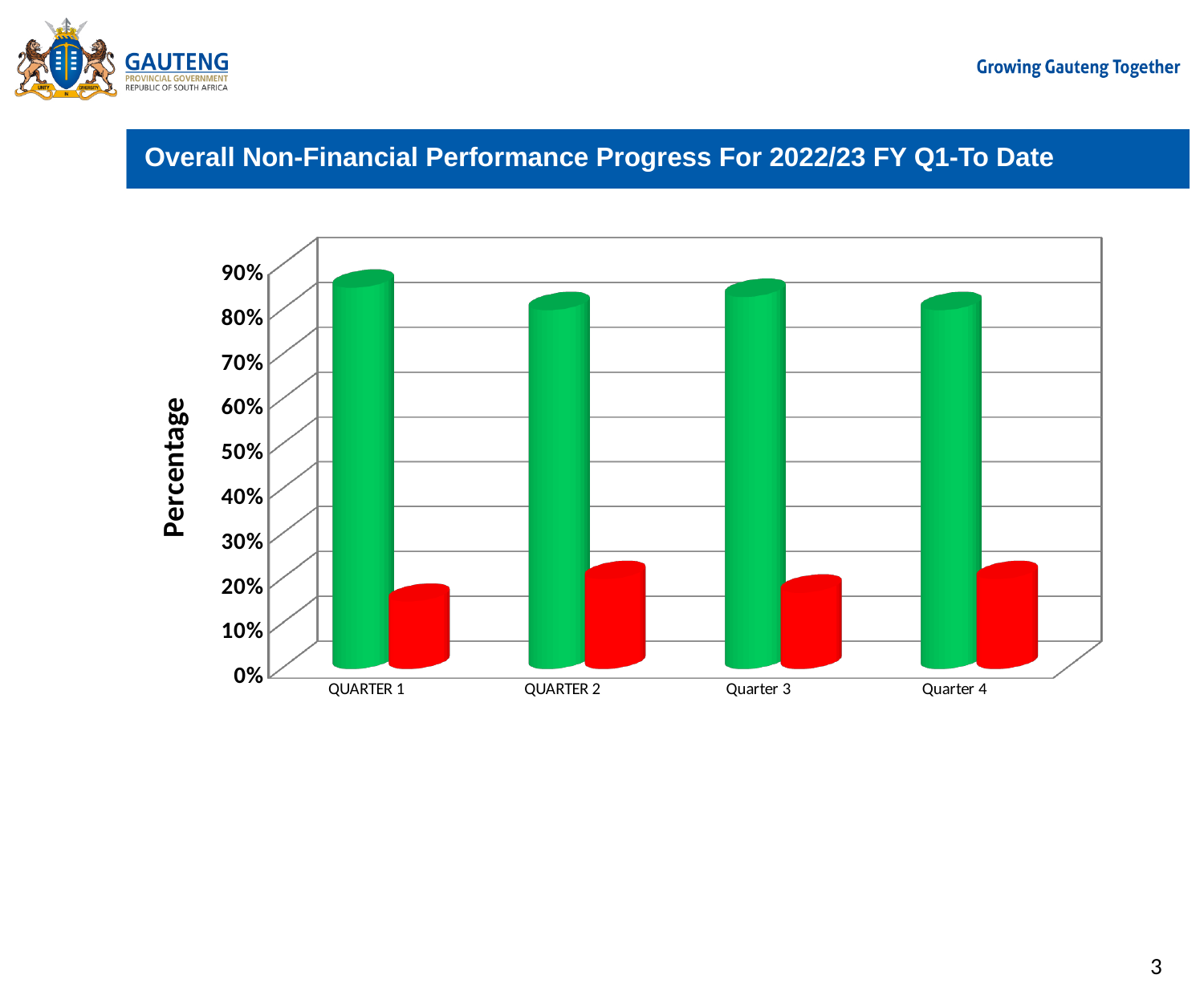
Is the value of the green bar for QUARTER 2 greater or less than 60%? greater In QUARTER 1, which bar is larger, the green bar or the red bar? the green bar Is the value of the red bar for QUARTER 1 greater or less than 30%? less What is the title of the vertical axis of the chart? Percentage What kind of chart is shown on the slide? bar chart Is the value of the red bar for Quarter 4 greater or less than 40%? less How many quarters (categories) are shown on the x axis of the chart? 4 What two colours are used for the bars in the chart? green and red How many bars are plotted for each quarter in the chart? 2 In Quarter 4, which bar is larger, the green bar or the red bar? the green bar